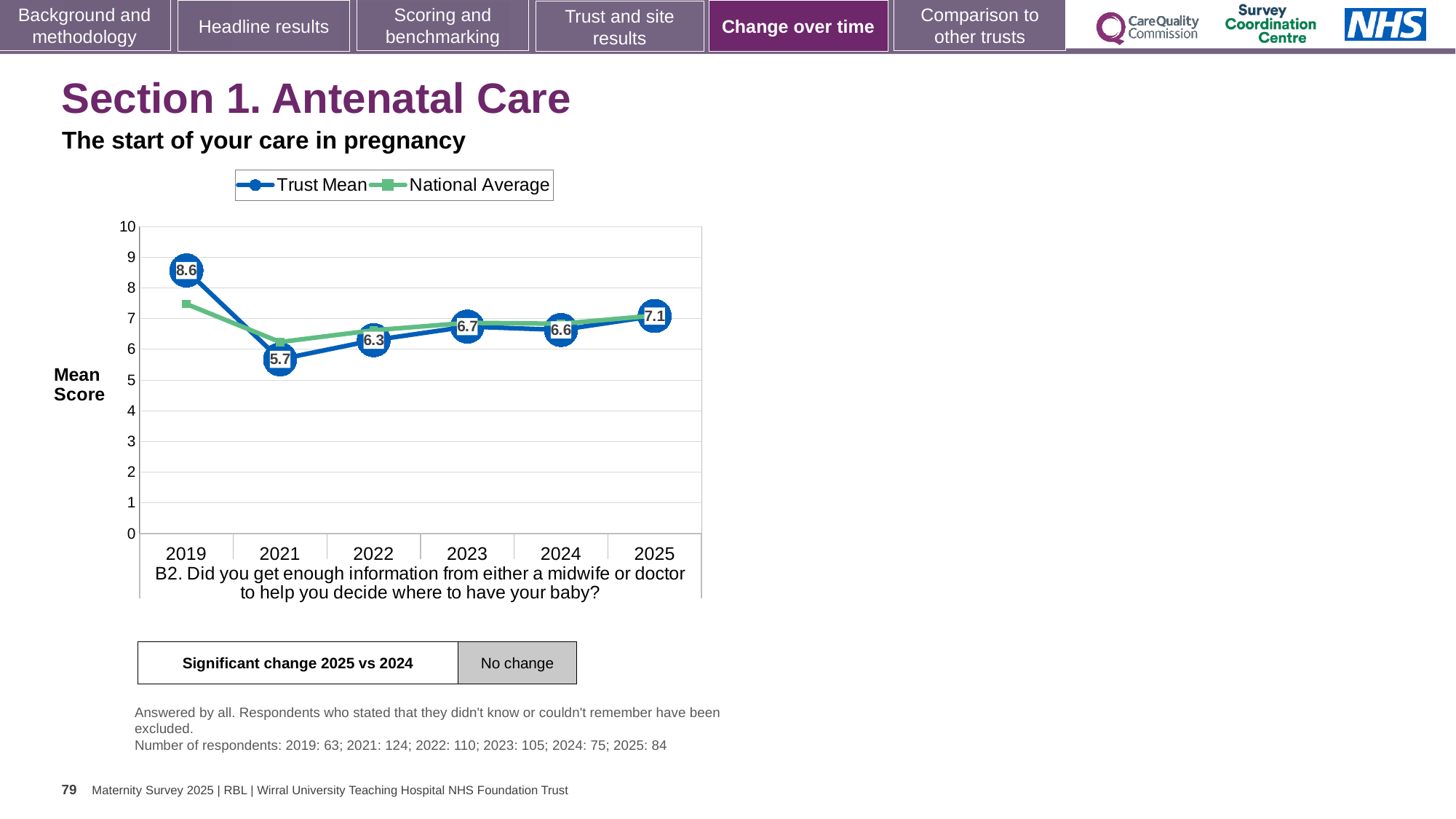
Which year has the larger Trust Mean score, 2023 or 2025? 2025 In which year is the Trust Mean score lowest? 2021 What is the difference between the Trust Mean scores for 2019 and 2021? 2.9 What kind of chart is shown on the slide? Line chart What is the Trust Mean score for 2019? 8.6 In which year is the Trust Mean score highest? 2019 How many years are plotted on the x axis? 6 How many series does the legend list? 2 What is the Trust Mean score for 2022? 6.3 What is the Trust Mean score for 2025? 7.1 Does the Trust Mean rise or fall from 2019 to 2021? Fall Is the National Average value for 2019 greater or less than 8? less